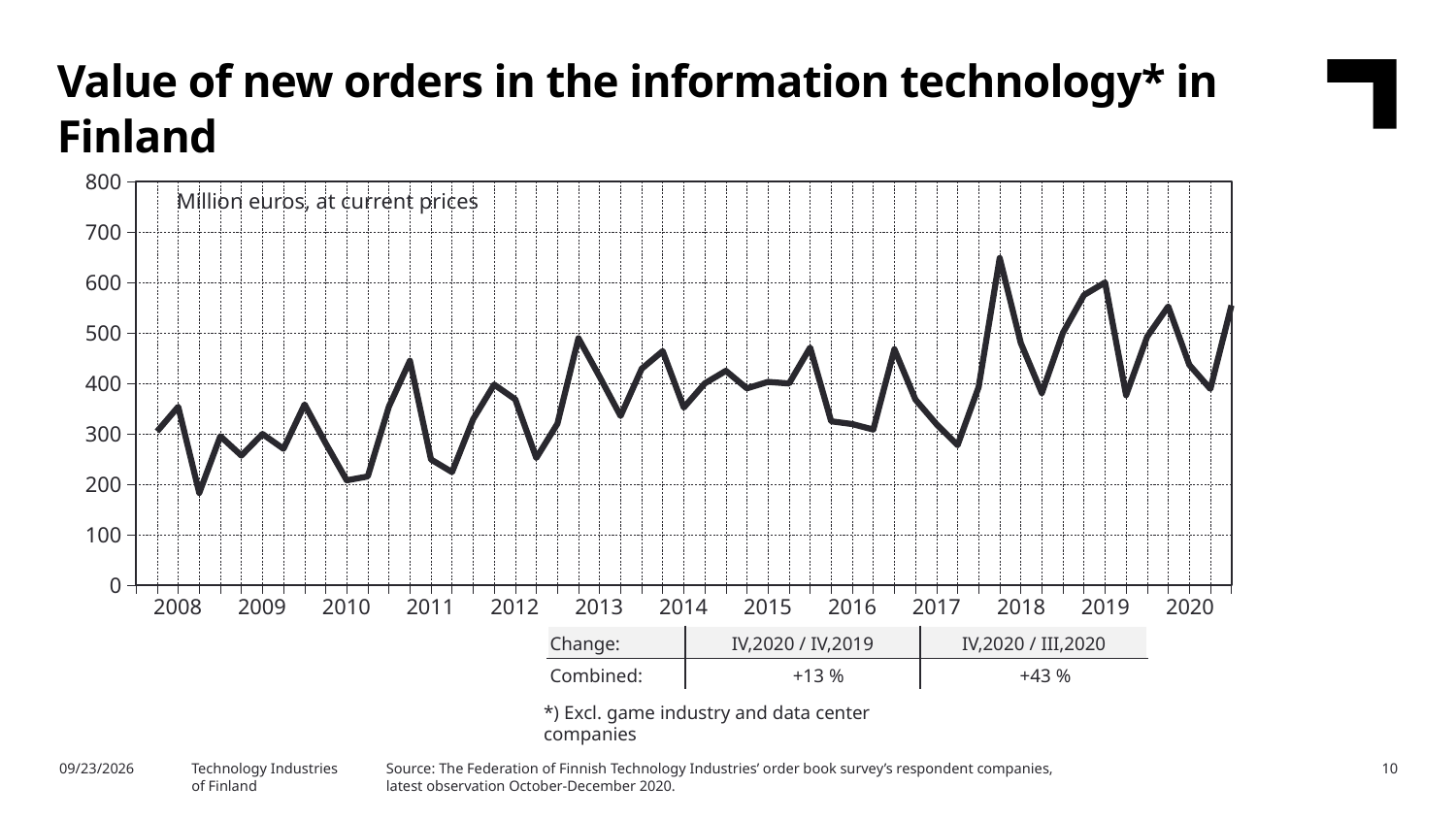
According to the table below the chart, what is the combined change for IV,2020 / III,2020? +43 % Is the lowest value in 2017 greater or less than 300? less What kind of chart is shown on the slide? line chart In which year does the line reach its highest point? 2018 Overall, do the values rise or fall from the start of 2008 to the end of 2020? rise Is the highest value on the chart, reached in 2018, greater or less than 600? greater In what unit are the values on the chart expressed? Million euros, at current prices Is the lowest value on the chart, reached in 2008, greater or less than 200? less How many years are labelled on the x axis of the chart? 13 What is the title of the chart on the slide? Value of new orders in the information technology* in Finland In which year does the line reach its lowest point? 2008